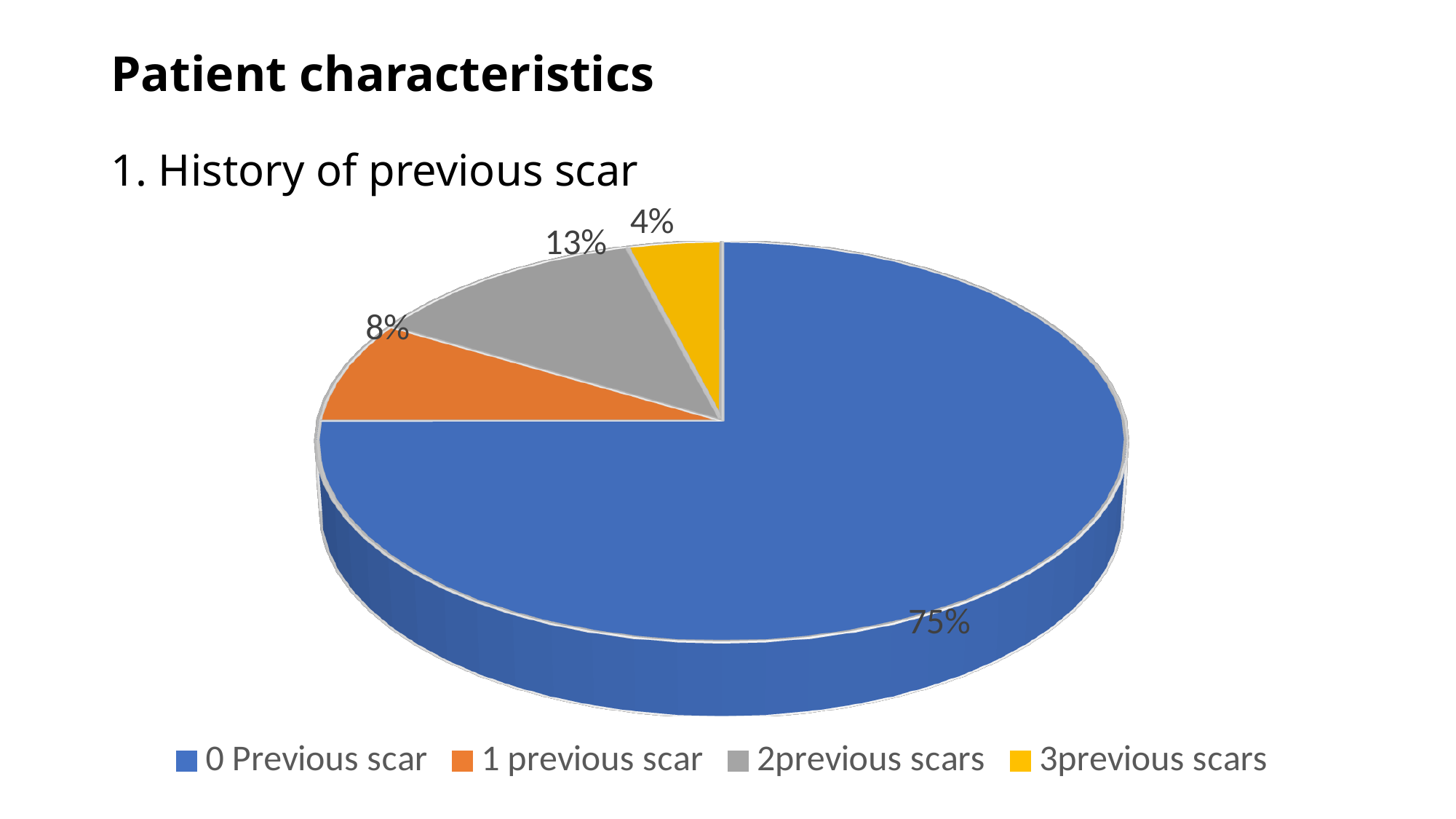
Which category has the largest share of the pie? 0 Previous scar What percentage of patients had 0 previous scars? 75% How many entries does the legend list? 4 What is the difference in percentage points between the 0 previous scar slice and the 2 previous scars slice? 62 What percentage of patients had 1 previous scar? 8% What kind of chart is shown on the slide? Pie chart What percentage of patients had 3 previous scars? 4% What colour is the slice for 3 previous scars? Yellow How many slices does the pie chart have? 4 What percentage of patients had 2 previous scars? 13% Which is larger: the share for 1 previous scar or the share for 2 previous scars? 2previous scars Which category has the smallest share of the pie? 3previous scars